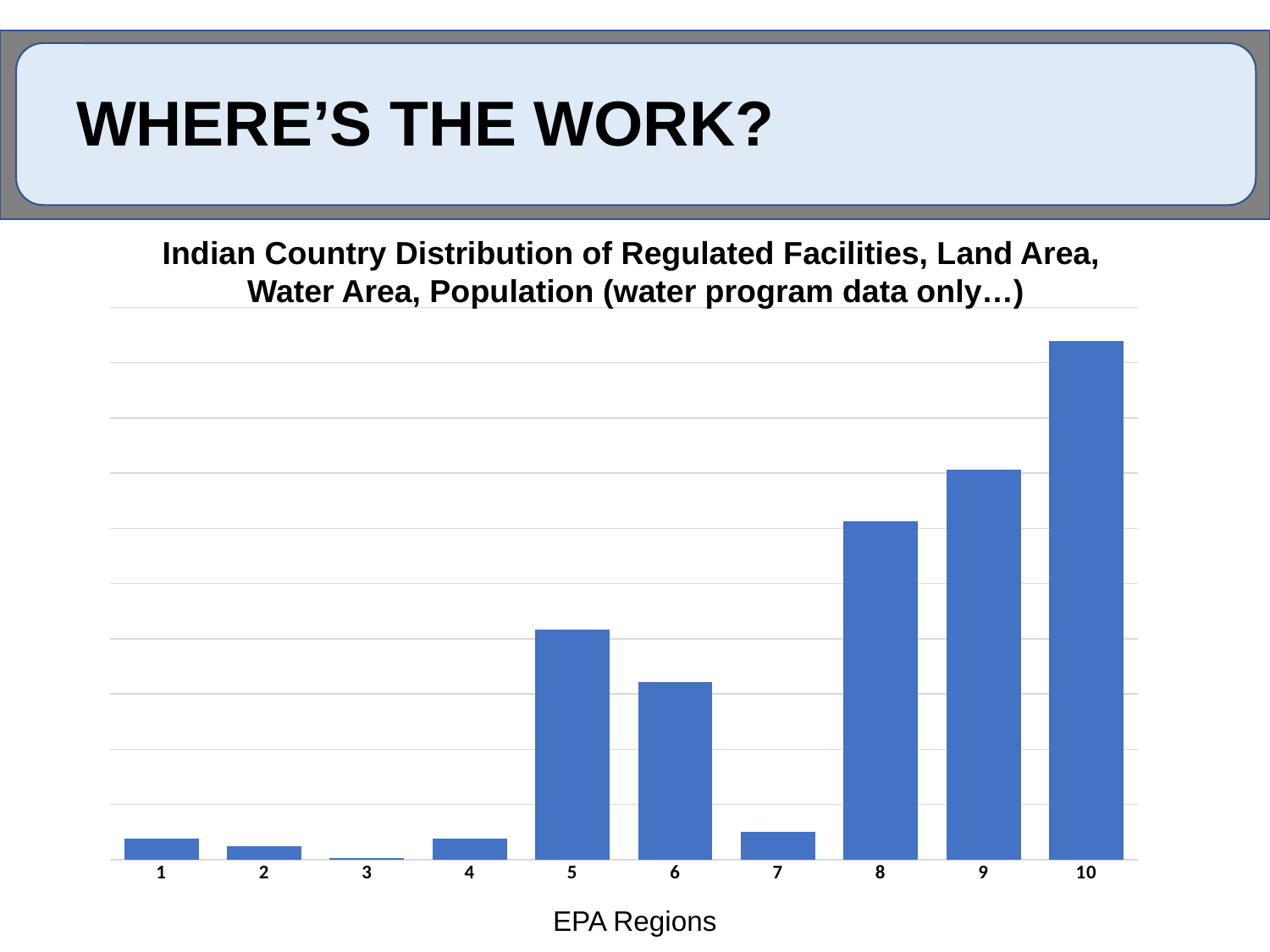
What kind of chart is shown on the slide? Bar chart Which EPA region has the highest value in the chart? 10 Do the values rise or fall from EPA region 8 through EPA region 10? Rise Which has the larger value, EPA region 8 or EPA region 9? 9 Which has the larger value, EPA region 5 or EPA region 6? 5 What is the label on the x axis of the chart? EPA Regions What is the title of the chart? Indian Country Distribution of Regulated Facilities, Land Area, Water Area, Population (water program data only…) Which has the larger value, EPA region 2 or EPA region 7? 7 How many EPA regions are shown on the x axis of the chart? 10 Which EPA region has the lowest value in the chart? 3